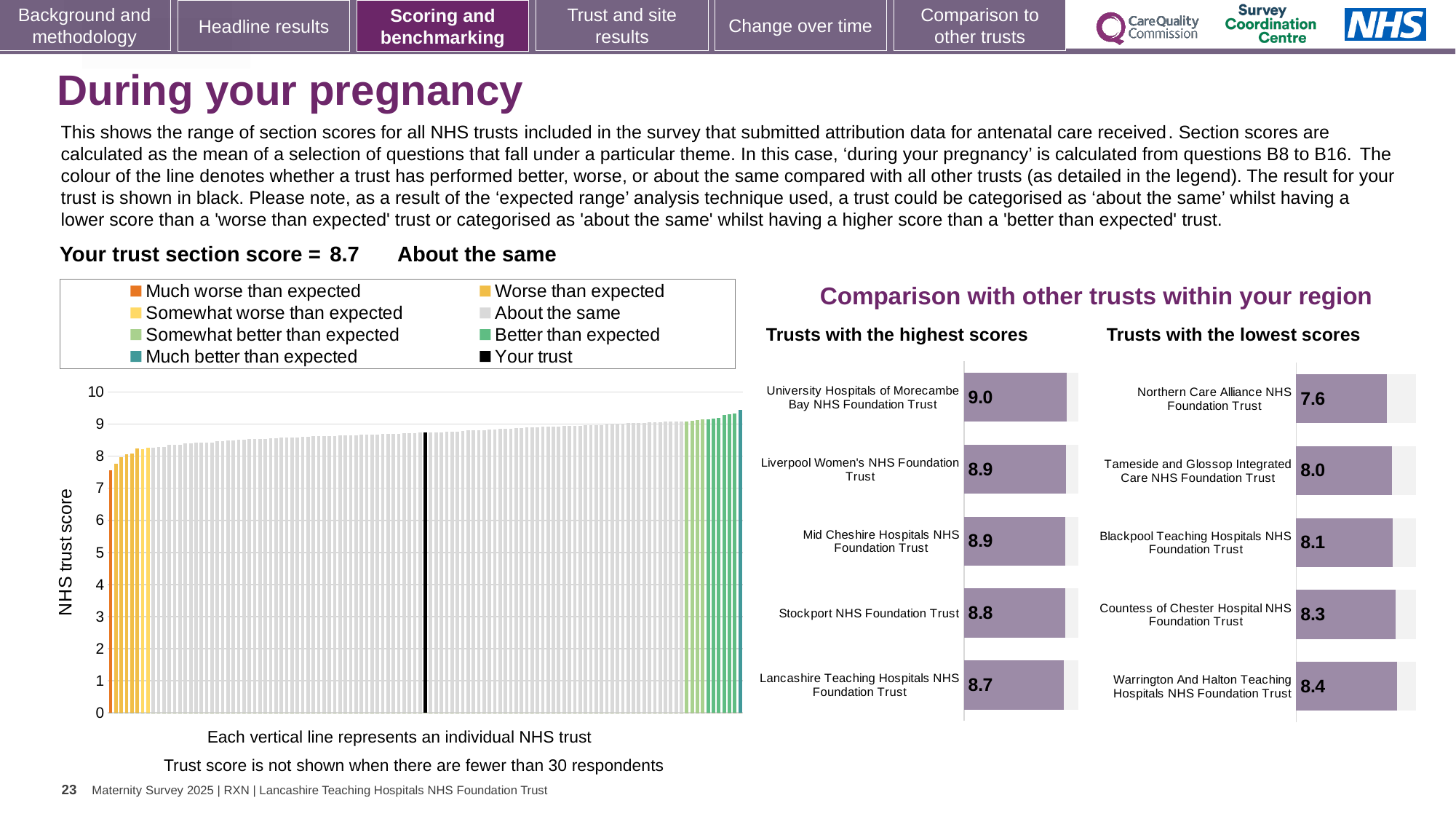
In the 'Trusts with the highest scores' chart, which trust has the highest score? University Hospitals of Morecambe Bay NHS Foundation Trust In the 'Trusts with the highest scores' chart, what is the score for Stockport NHS Foundation Trust? 8.8 In the 'Trusts with the highest scores' chart, what is the score for University Hospitals of Morecambe Bay NHS Foundation Trust? 9.0 In the large 'NHS trust score' chart on the left, is the value of the black bar representing your trust greater or less than 8? greater In the 'Trusts with the lowest scores' chart, what is the score for Northern Care Alliance NHS Foundation Trust? 7.6 What kind of chart is the large 'NHS trust score' chart on the left? Bar chart In the 'Trusts with the highest scores' chart, what is the difference between the scores of University Hospitals of Morecambe Bay NHS Foundation Trust and Lancashire Teaching Hospitals NHS Foundation Trust? 0.3 In the 'Trusts with the lowest scores' chart, which has the larger score: Blackpool Teaching Hospitals NHS Foundation Trust or Countess of Chester Hospital NHS Foundation Trust? Countess of Chester Hospital NHS Foundation Trust In the 'Trusts with the lowest scores' chart, what is the difference between the scores of Warrington And Halton Teaching Hospitals NHS Foundation Trust and Northern Care Alliance NHS Foundation Trust? 0.8 In the 'Trusts with the highest scores' chart, how many trusts are shown? 5 In the 'Trusts with the lowest scores' chart, which trust has the lowest score? Northern Care Alliance NHS Foundation Trust In the 'Trusts with the lowest scores' chart, what is the score for Countess of Chester Hospital NHS Foundation Trust? 8.3